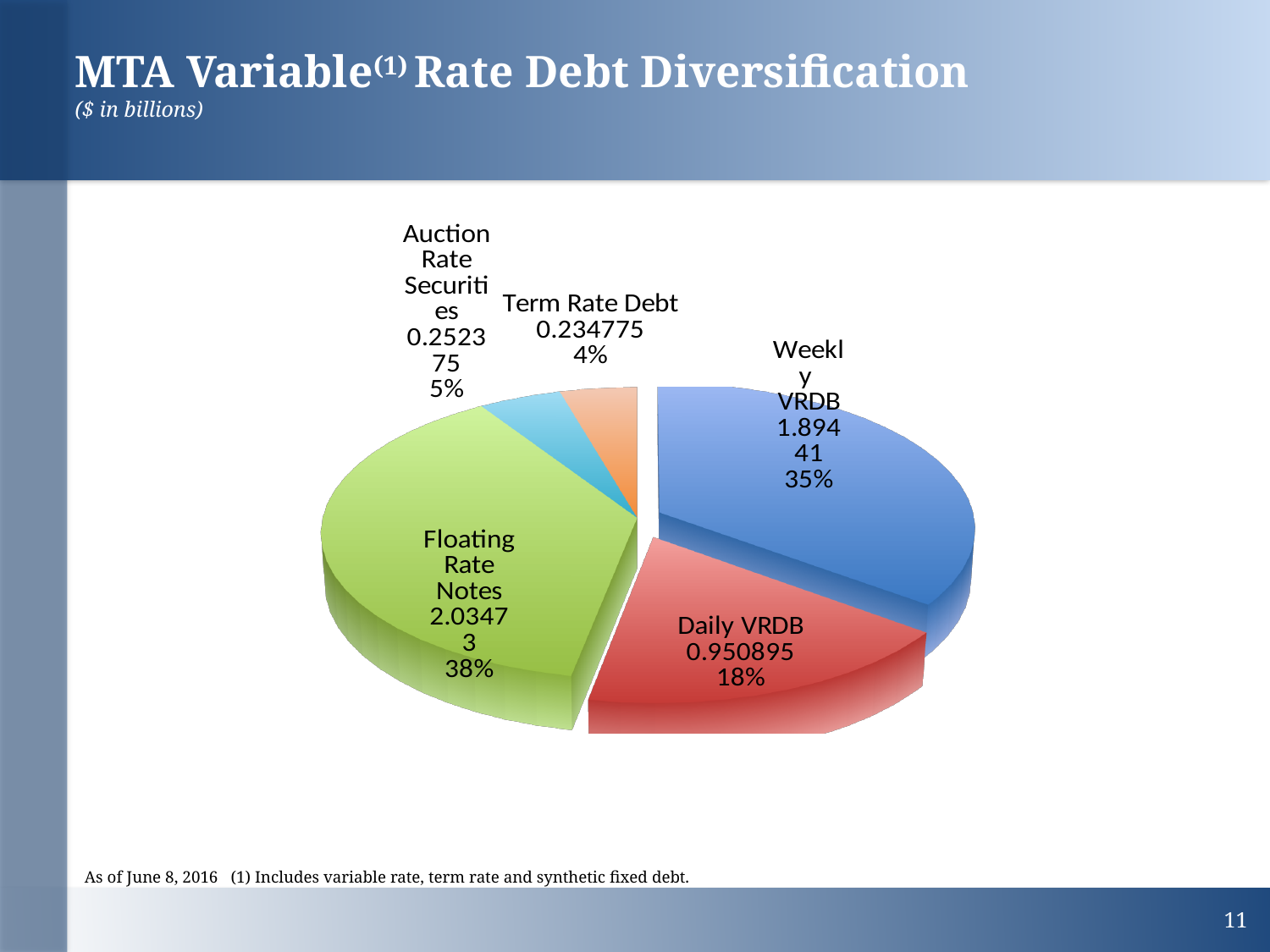
What value is shown for Floating Rate Notes? 2.03473 What type of chart is shown on the slide? Pie chart What percentage share of the pie does Auction Rate Securities represent? 5% What value is shown for Weekly VRDB? 1.89441 Which is larger, Weekly VRDB or Daily VRDB? Weekly VRDB How many categories are shown in the pie chart? 5 What value is shown for Term Rate Debt? 0.234775 What percentage share of the pie does Daily VRDB represent? 18% What is the difference between the values for Floating Rate Notes and Weekly VRDB? 0.14032 Which category has the largest slice of the pie? Floating Rate Notes Which category has the smallest slice of the pie? Term Rate Debt What value is shown for Daily VRDB? 0.950895